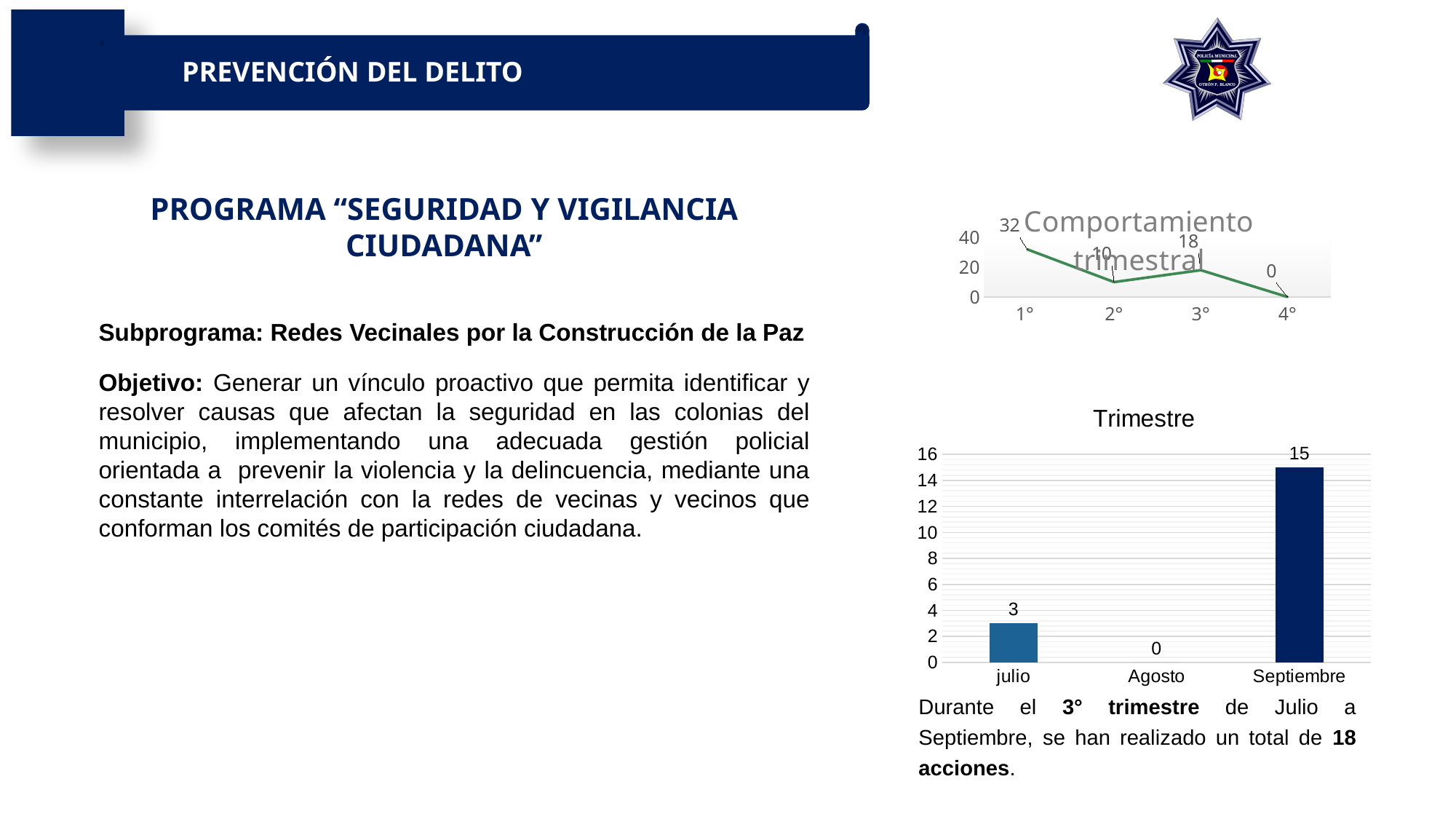
In the "Comportamiento trimestral" line chart, is the value for the 2° quarter larger or smaller than the value for the 3° quarter? Smaller In the "Trimestre" bar chart, how many months are shown on the x axis? 3 In the "Trimestre" bar chart, what is the value for Septiembre? 15 What kind of chart is the "Trimestre" chart? Bar chart In the "Comportamiento trimestral" line chart, what is the value for the 1° quarter? 32 In the "Trimestre" bar chart, what is the value for julio? 3 In the "Trimestre" bar chart, which month has the highest value? Septiembre What kind of chart is the "Comportamiento trimestral" chart? Line chart In the "Comportamiento trimestral" line chart, what is the value for the 3° quarter? 18 In the "Trimestre" bar chart, which month has the lowest value? Agosto In the "Trimestre" bar chart, what is the difference between the values for Septiembre and julio? 12 In the "Comportamiento trimestral" line chart, which quarter has the highest value? 1°